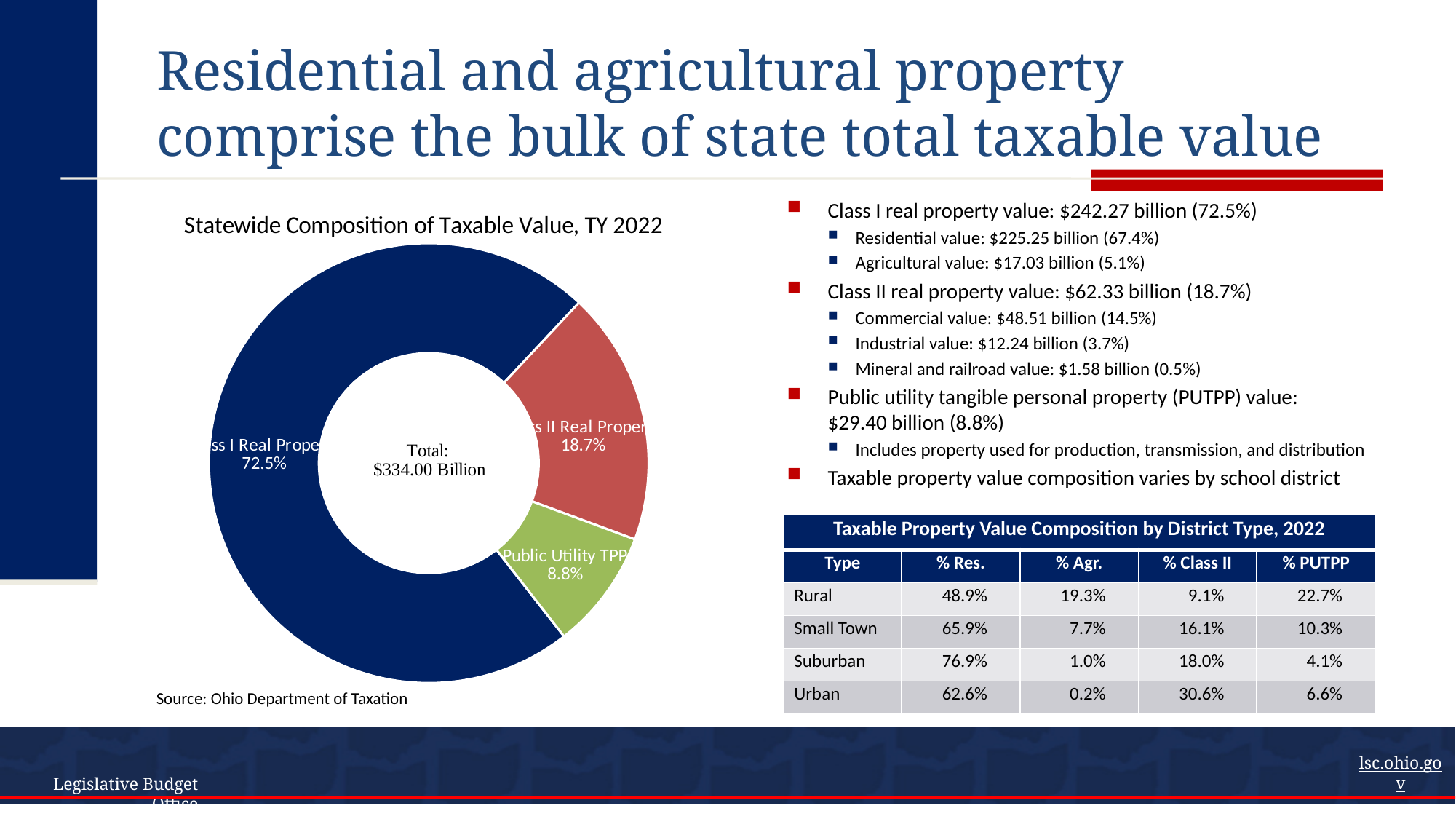
Which slice of the pie chart is the largest? Class I Real Property What share of the pie does Class II Real Property represent? 18.7% What share of the pie does Public Utility TPP represent? 8.8% What share of the pie does Class I Real Property represent? 72.5% What is the title of the chart on the slide? Statewide Composition of Taxable Value, TY 2022 What colour is the Public Utility TPP slice in the pie chart? Green What kind of chart is shown on the slide? Pie chart (donut) What is the difference in percentage points between the Class I Real Property and Class II Real Property slices? 53.8 percentage points What total value is shown in the center of the donut chart? $334.00 Billion How many slices does the pie chart have? 3 Which slice of the pie chart is the smallest? Public Utility TPP Which is larger in the pie chart, Class II Real Property or Public Utility TPP? Class II Real Property